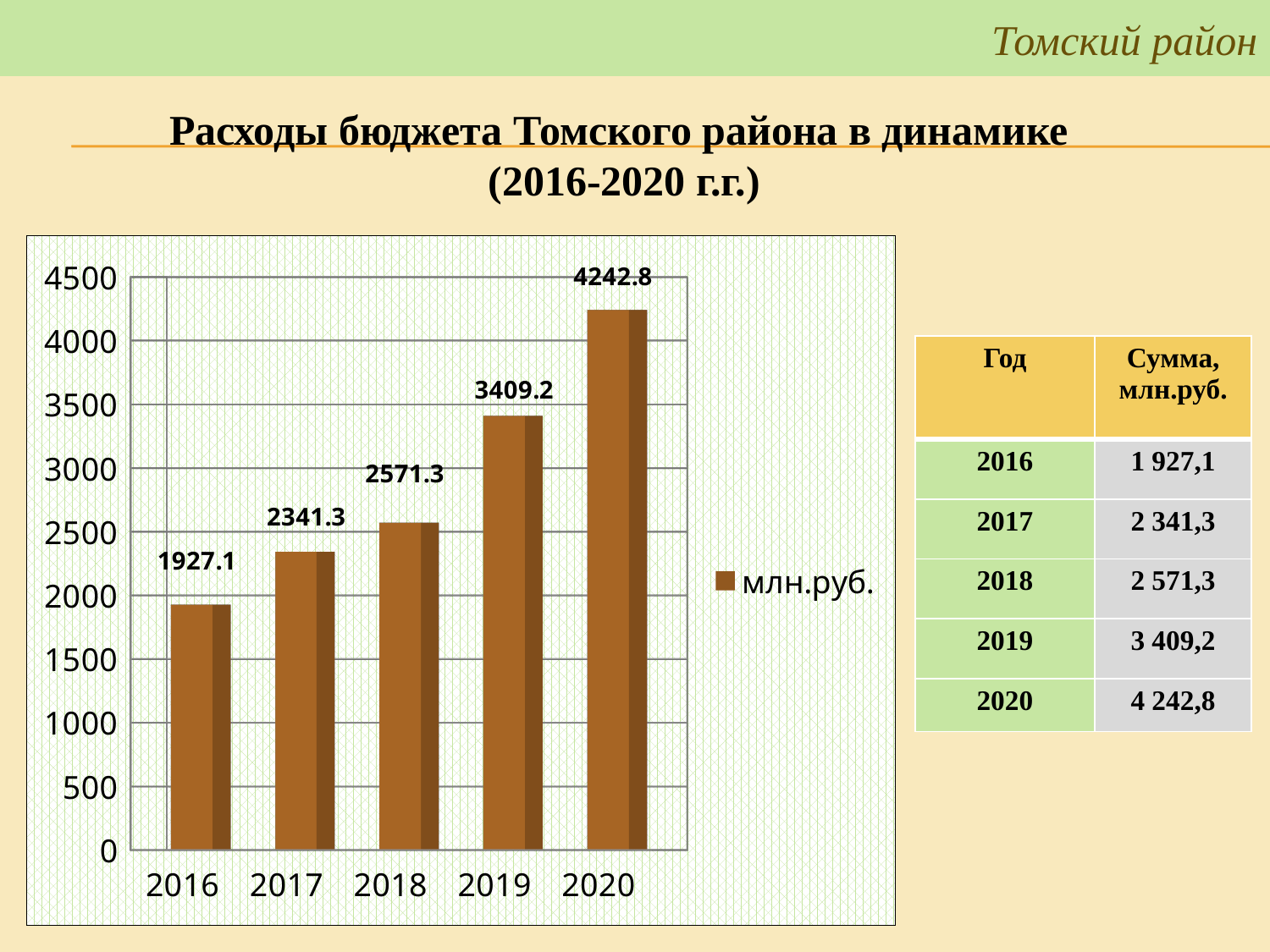
What kind of chart is shown on the slide? bar chart Which is larger, the value for 2018 or the value for 2019? 2019 What is the difference between the values for 2017 and 2016? 414.2 What is the difference between the values for 2020 and 2019? 833.6 Which year has the lowest value in the chart? 2016 Do the values rise or fall from 2016 to 2020? rise What is the value for 2018 in the chart? 2571.3 What is the value for 2020 in the chart? 4242.8 Which year has the highest value in the chart? 2020 What is the value for 2016 in the chart? 1927.1 How many years are shown on the x axis of the chart? 5 Is the value for 2019 greater or less than 3000? greater